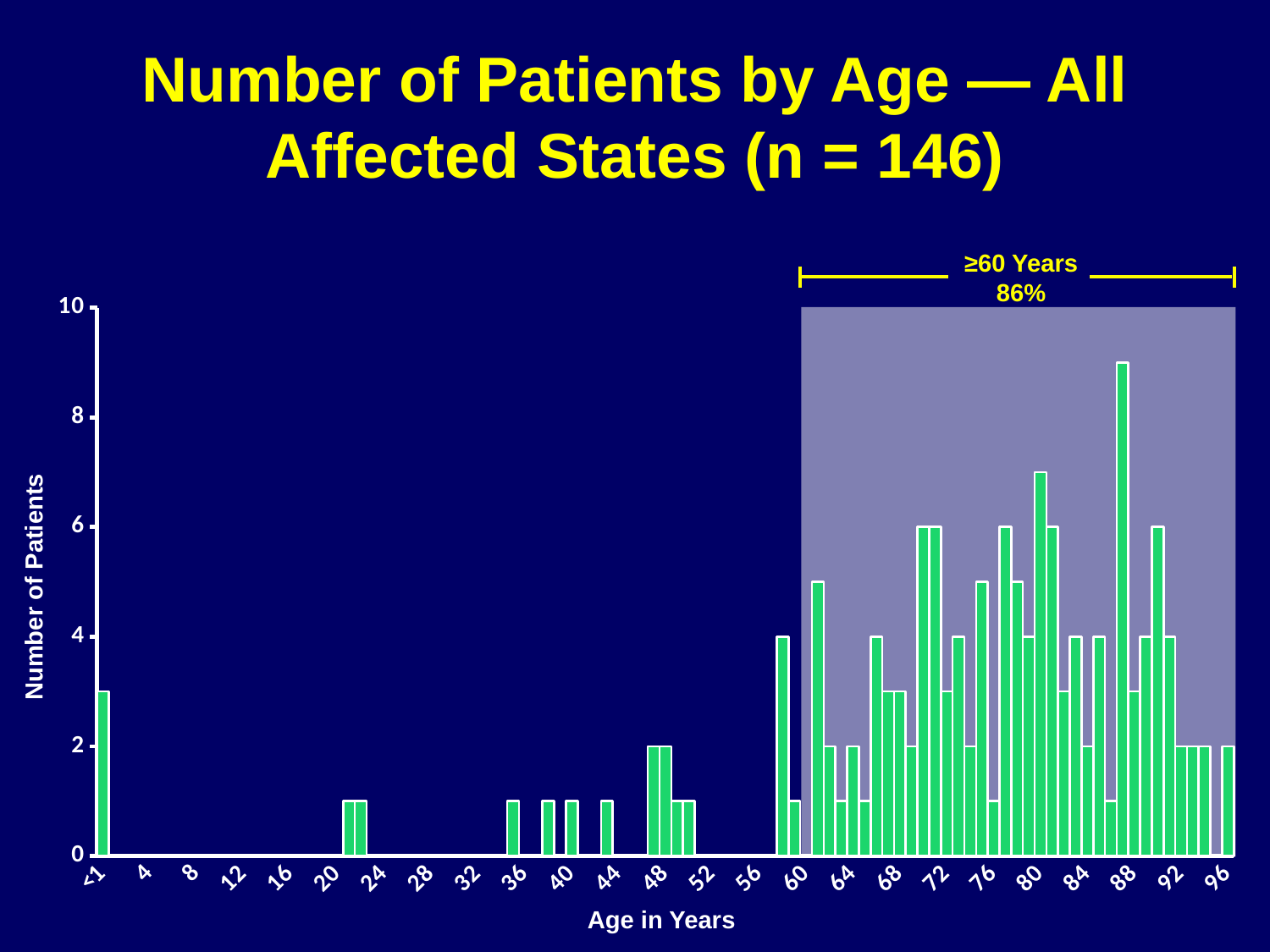
Is the number of patients at age 84 greater or less than 6? less What is the label of the y axis? Number of Patients What is the total number of patients (n) given in the chart title? 146 Is the number of patients at age 88 greater or less than 8? less Is the number of patients aged <1 greater or less than 2? greater What kind of chart is shown on the slide? bar chart What percentage of patients are in the ≥60 Years group according to the annotation on the chart? 86% At which age is the number of patients highest? 87 What is the title of the chart? Number of Patients by Age — All Affected States (n = 146)